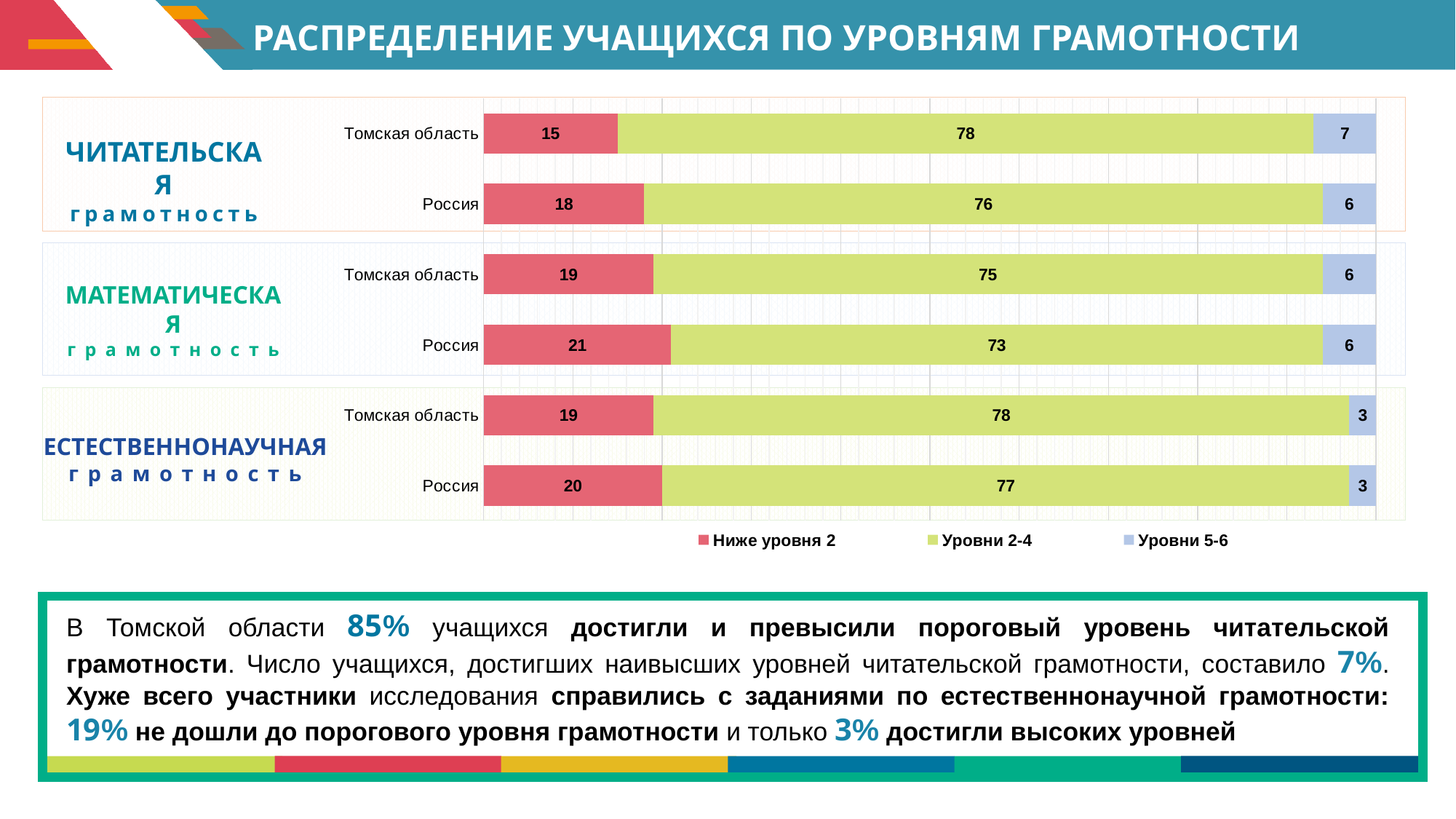
Which bar has the lowest value for "Ниже уровня 2"? Томская область, читательская грамотность What is the value of "Уровни 2-4" for Россия in математическая грамотность? 73 How many bars are plotted in the chart? 6 Which bar has the highest value for "Ниже уровня 2"? Россия, математическая грамотность What is the value of "Ниже уровня 2" for Томская область in читательская грамотность? 15 What is the total of the stacked bar for Россия in естественнонаучная грамотность? 100 How many series does the legend list? 3 What type of chart is shown on the slide? Stacked bar chart What is the value of "Уровни 5-6" for Томская область in читательская грамотность? 7 What is the difference between the "Ниже уровня 2" values for Россия and Томская область in читательская грамотность? 3 What is the value of "Уровни 5-6" for Томская область in естественнонаучная грамотность? 3 Which is larger: the "Уровни 2-4" value for Томская область in математическая грамотность or for Россия in математическая грамотность? Томская область